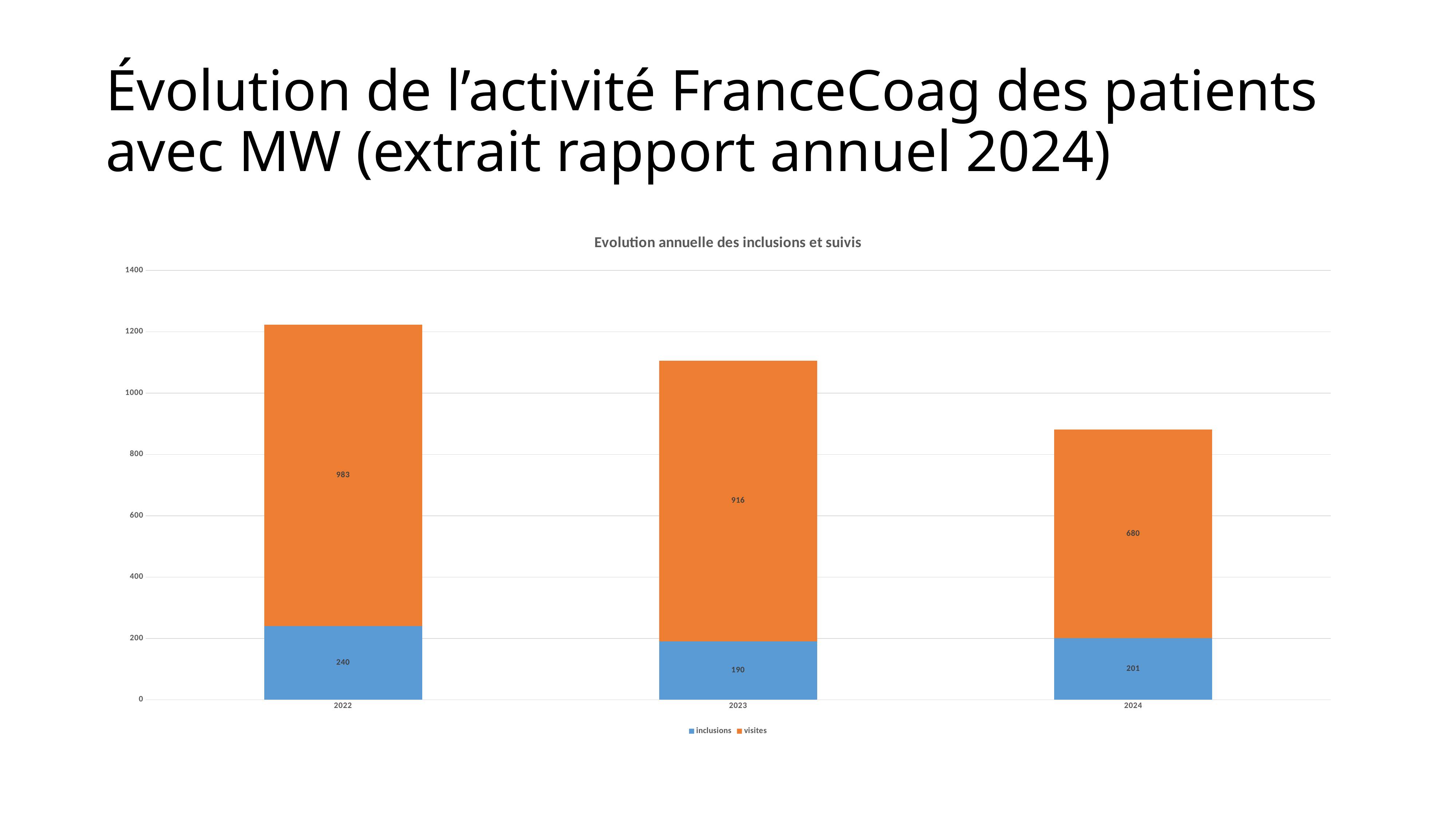
Is the total stacked bar for 2024 greater or less than 1000? less What is the value of visites for 2023? 916 Which is larger: inclusions in 2022 or inclusions in 2024? inclusions in 2022 What is the difference between visites in 2022 and visites in 2024? 303 What is the total of the stacked bar for 2023? 1106 What is the value of inclusions for 2022? 240 Which year has the lowest number of inclusions? 2023 Which year has the highest number of visites? 2022 How many years are shown on the x axis? 3 What is the value of visites for 2024? 680 How many series does the legend list? 2 What kind of chart is shown? stacked bar chart